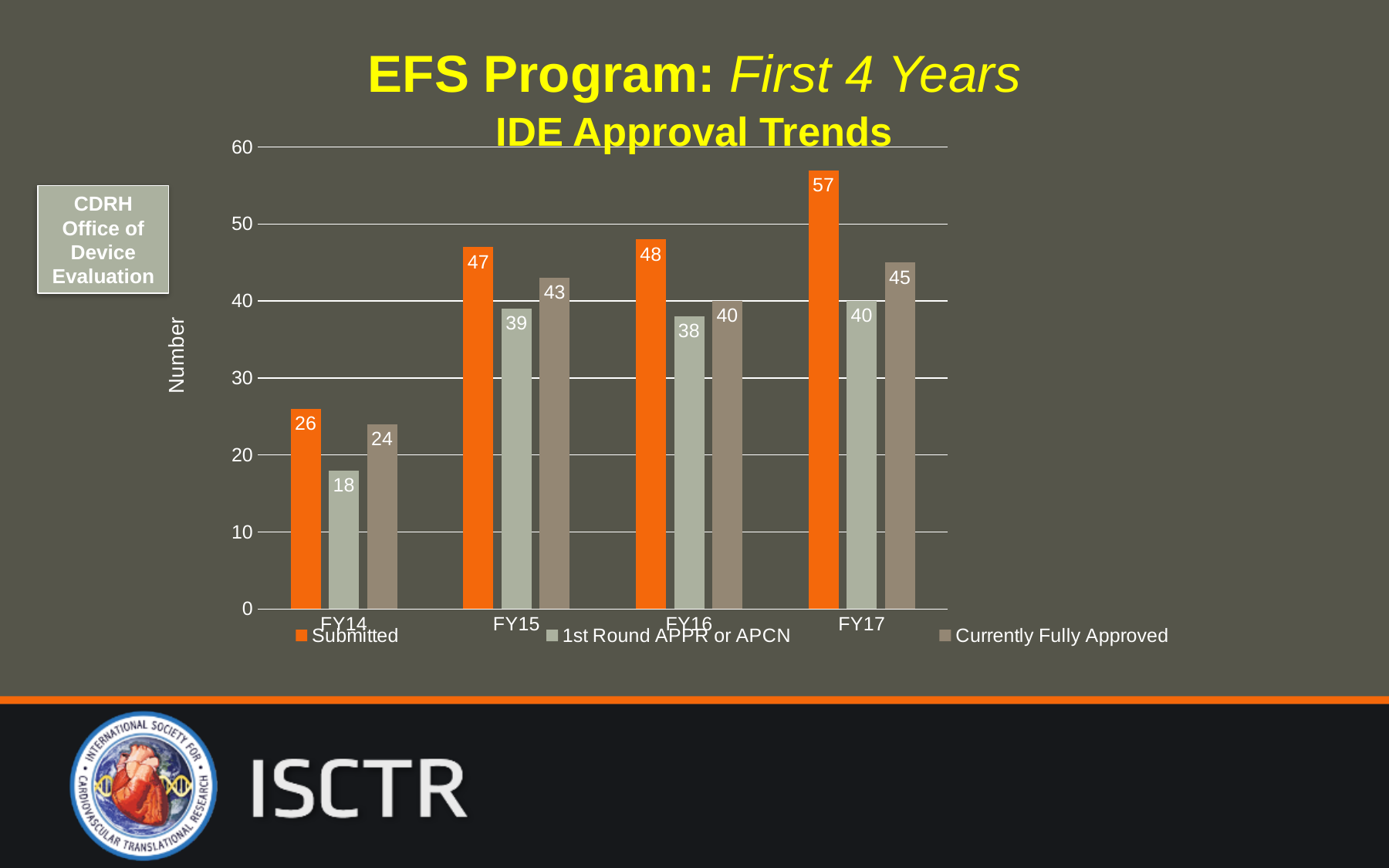
What kind of chart is shown? Bar chart Which fiscal year has the highest Submitted value? FY17 What is the difference between the Submitted value and the Currently Fully Approved value for FY17? 12 Which fiscal year has the lowest Currently Fully Approved value? FY14 What is the Submitted value for FY17? 57 Do the Submitted values rise or fall from FY14 to FY17? Rise How many fiscal years are shown on the x axis? 4 Which is larger for FY16: the 1st Round APPR or APCN value or the Currently Fully Approved value? Currently Fully Approved What is the Currently Fully Approved value for FY15? 43 What is the 1st Round APPR or APCN value for FY14? 18 What is the title of the chart? IDE Approval Trends How many series does the legend list? 3